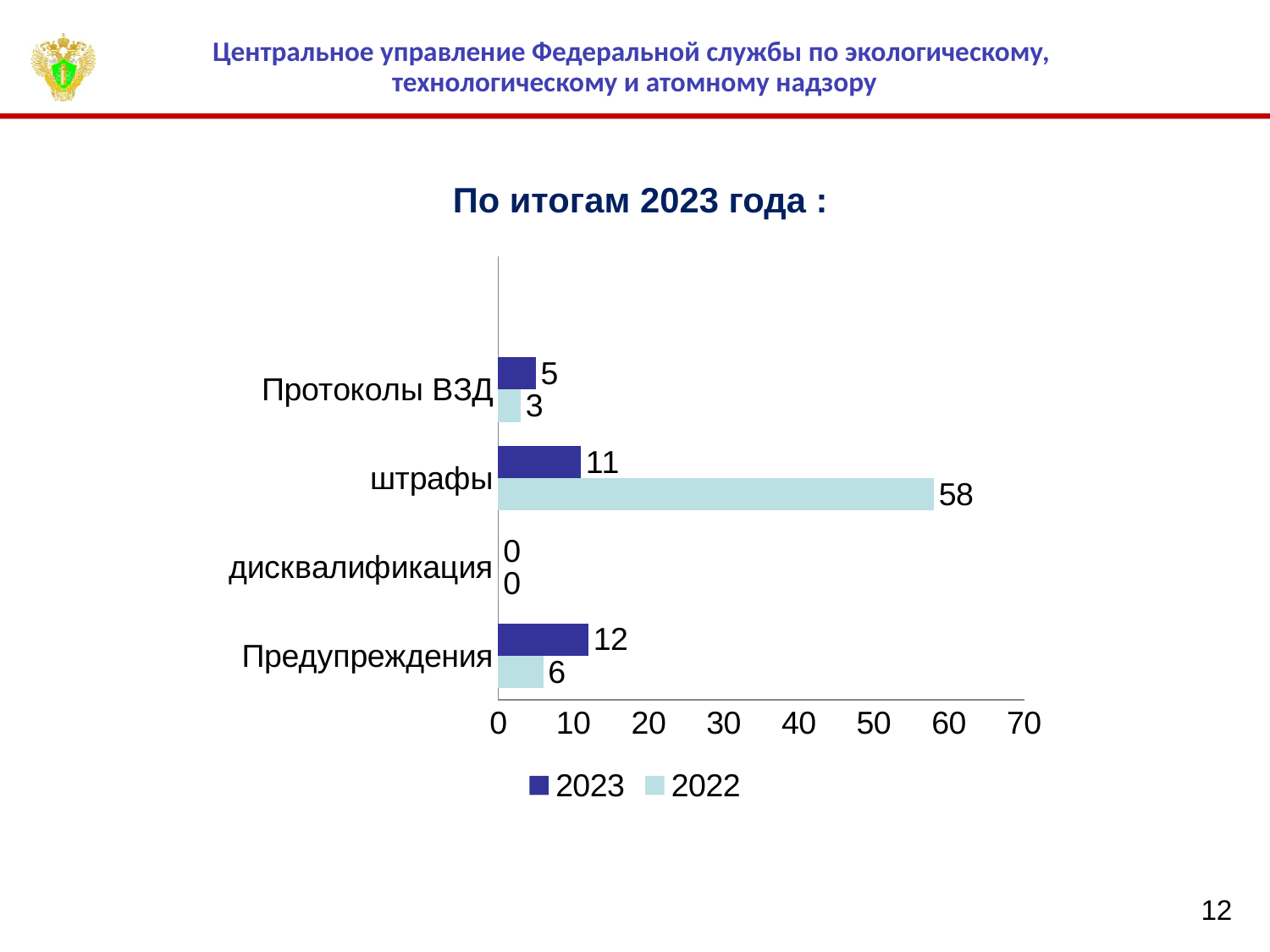
What is the value for штрафы in 2022? 58 What is the difference between the 2022 and 2023 values for штрафы? 47 Which is larger for Предупреждения: the 2023 value or the 2022 value? 2023 How many series does the legend list? 2 Is the 2022 value for штрафы greater or less than 50? greater What is the value for Протоколы ВЗД in 2022? 3 What is the value for дисквалификация in 2023? 0 What kind of chart is shown on the slide? bar chart What is the value for Предупреждения in 2023? 12 Which category has the highest value in the 2022 series? штрафы How many categories are shown on the chart? 4 Which category has the highest value in the 2023 series? Предупреждения